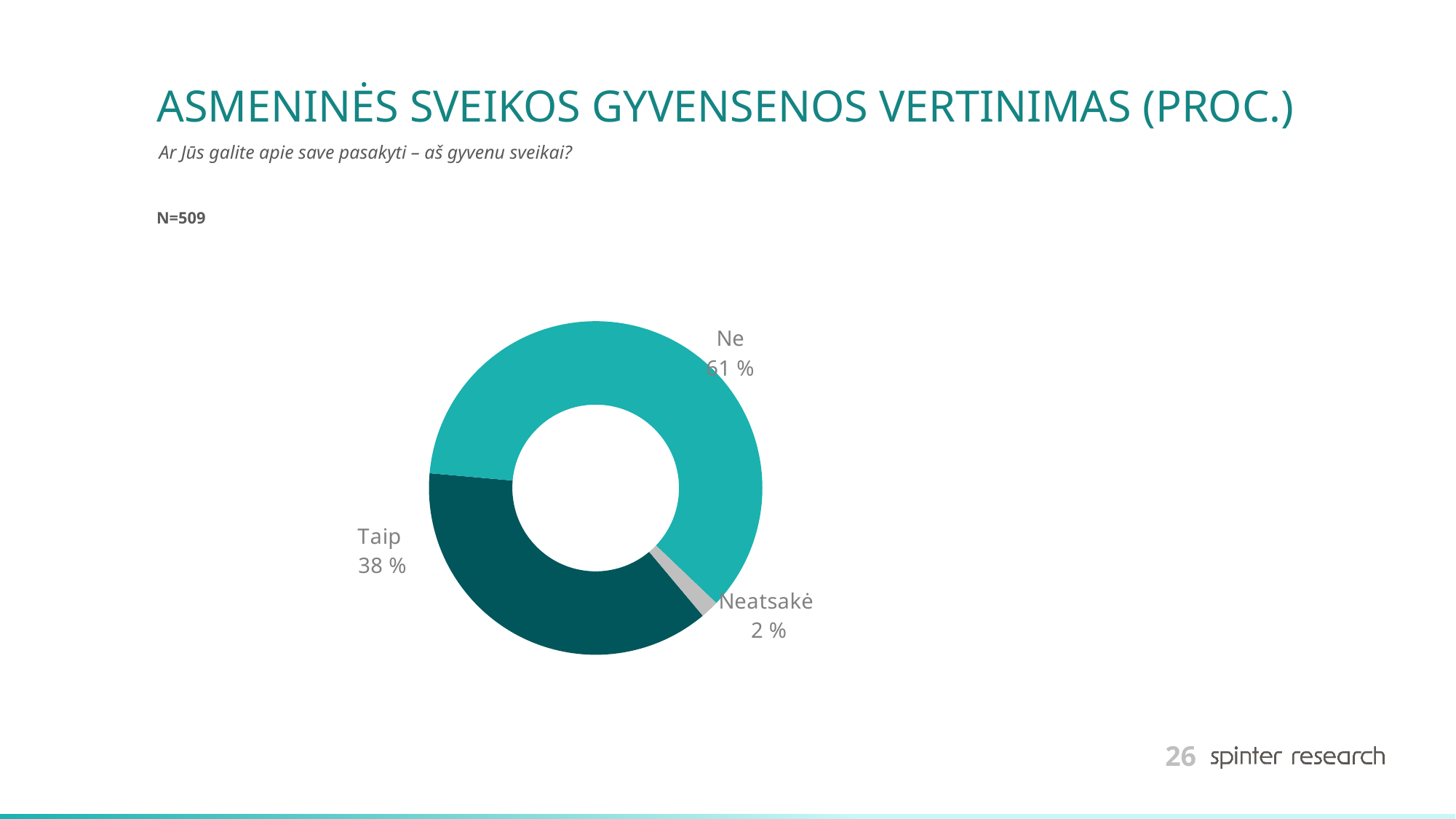
What percentage of respondents answered "Taip"? 38 % What percentage of respondents answered "Neatsakė"? 2 % Which answer has the smallest share of the chart? Neatsakė How many categories are shown in the chart? 3 What is the combined share of "Taip" and "Ne"? 99 % What is the difference in percentage points between "Ne" and "Taip"? 23 What percentage of respondents answered "Ne"? 61 % Which answer has the largest share of the chart? Ne What is the title of the slide? ASMENINĖS SVEIKOS GYVENSENOS VERTINIMAS (PROC.) Which is larger, the share for "Taip" or the share for "Neatsakė"? Taip What is the sample size (N) stated on the slide? N=509 What kind of chart is shown on the slide? Pie chart (doughnut)